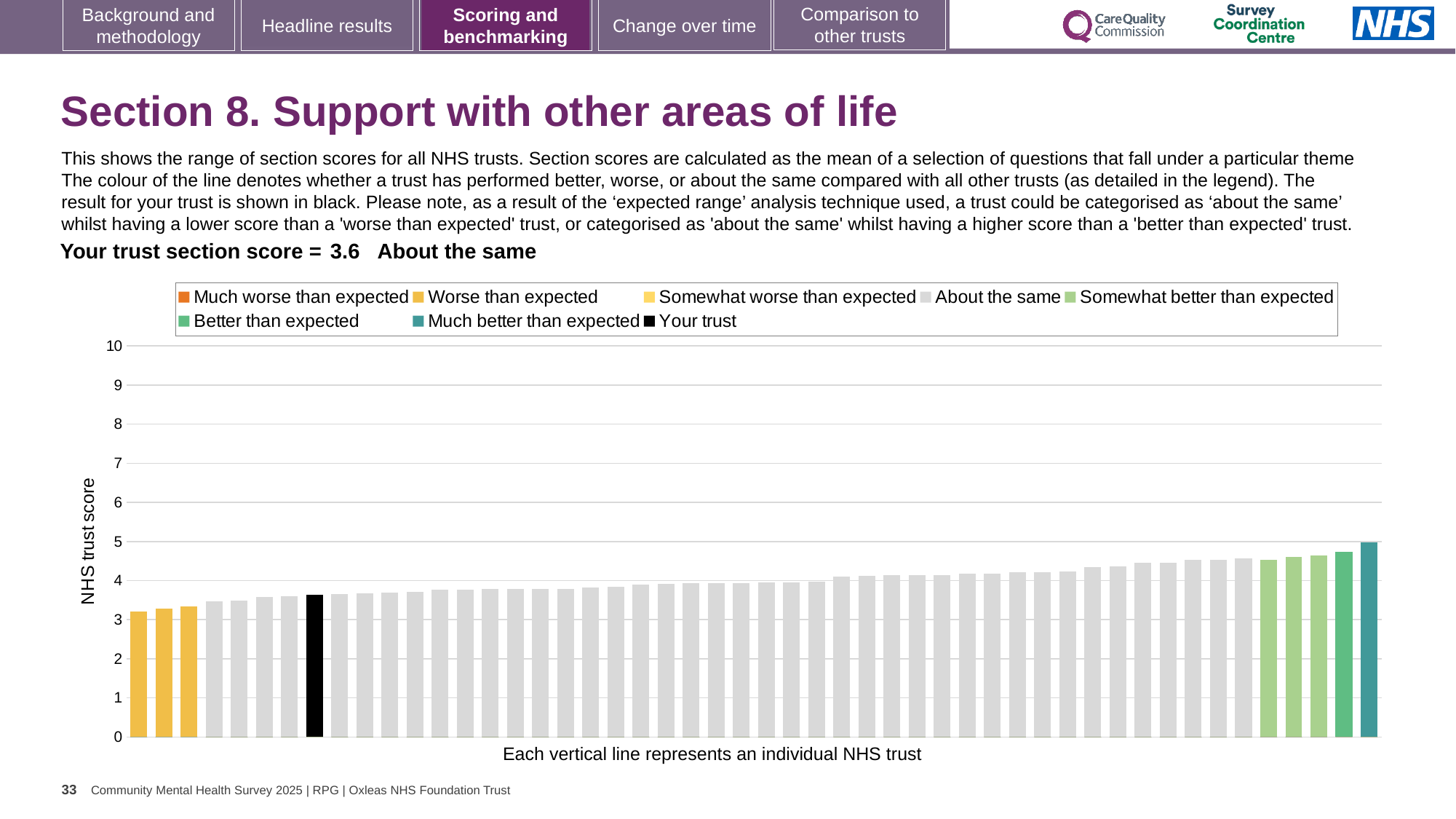
What is the section score for your trust shown on the slide? 3.6 Is the value of the leftmost bar greater or less than 3? greater Is the value of the tallest bar (Much better than expected) greater or less than 4? greater Which legend category does the highest-scoring trust belong to? Much better than expected How many bars are coloured as 'Worse than expected'? 3 Which performance category is your trust placed in for this section? About the same Do the trust scores rise or fall moving from left to right along the x axis? rise Is the value of the black 'Your trust' bar greater or less than 4? less How many entries does the chart legend list? 8 What is the label on the vertical axis of the chart? NHS trust score What kind of chart is shown on the slide? bar chart Which legend category does the lowest-scoring trust belong to? Worse than expected